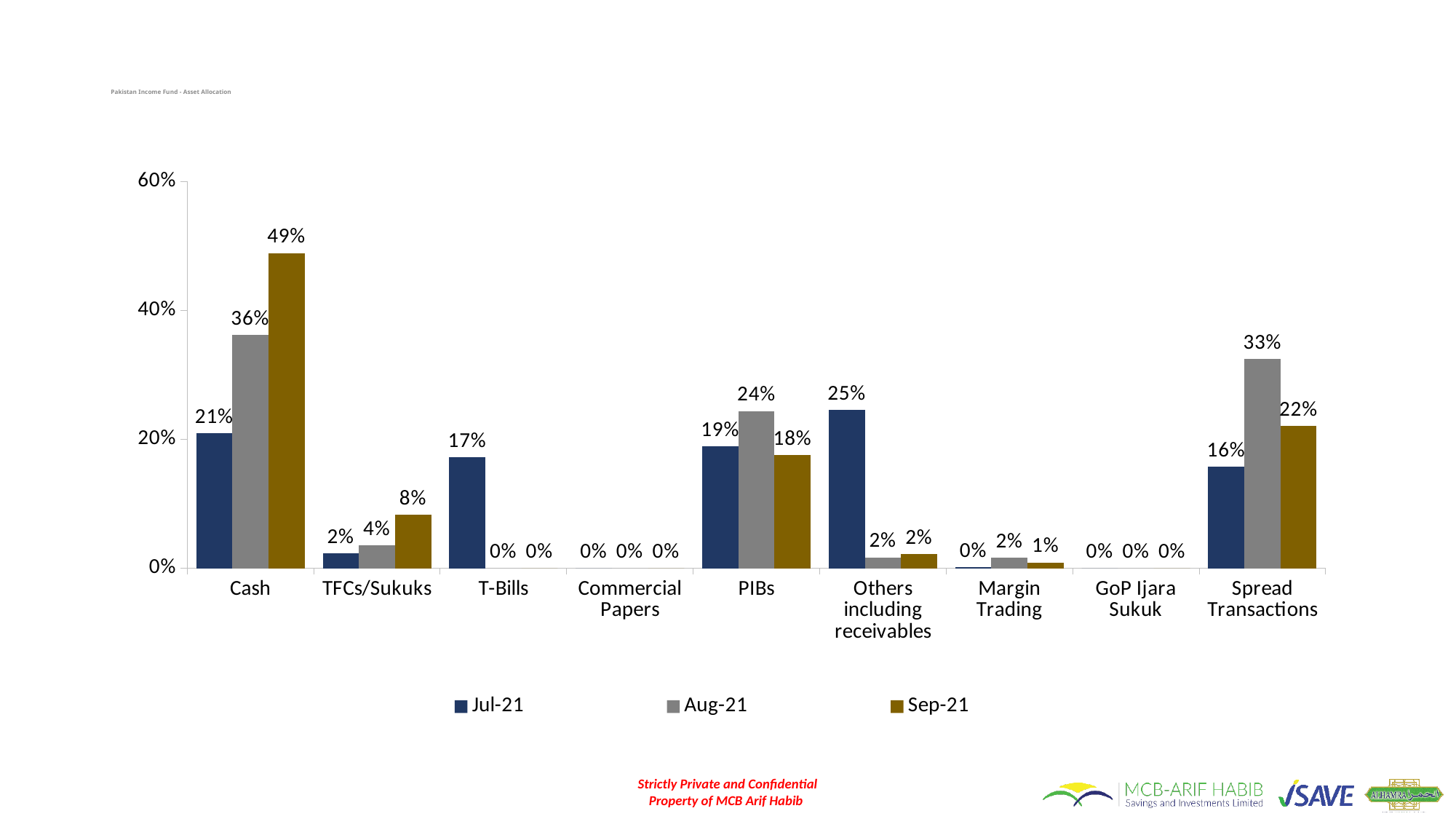
What is the difference between the Sep-21 and Jul-21 values for Cash? 28% Which is larger for Spread Transactions, the Aug-21 value or the Sep-21 value? Aug-21 How many categories are shown on the x axis? 9 What is the Sep-21 value for Cash? 49% What is the Aug-21 value for Spread Transactions? 33% Which category has the highest Sep-21 value? Cash What kind of chart is shown on the slide? Bar chart What is the Jul-21 value for T-Bills? 17% Which category has the highest Jul-21 value? Others including receivables What is the Aug-21 value for PIBs? 24% Do the values for Cash rise or fall from Jul-21 to Sep-21? Rise How many series does the legend list? 3